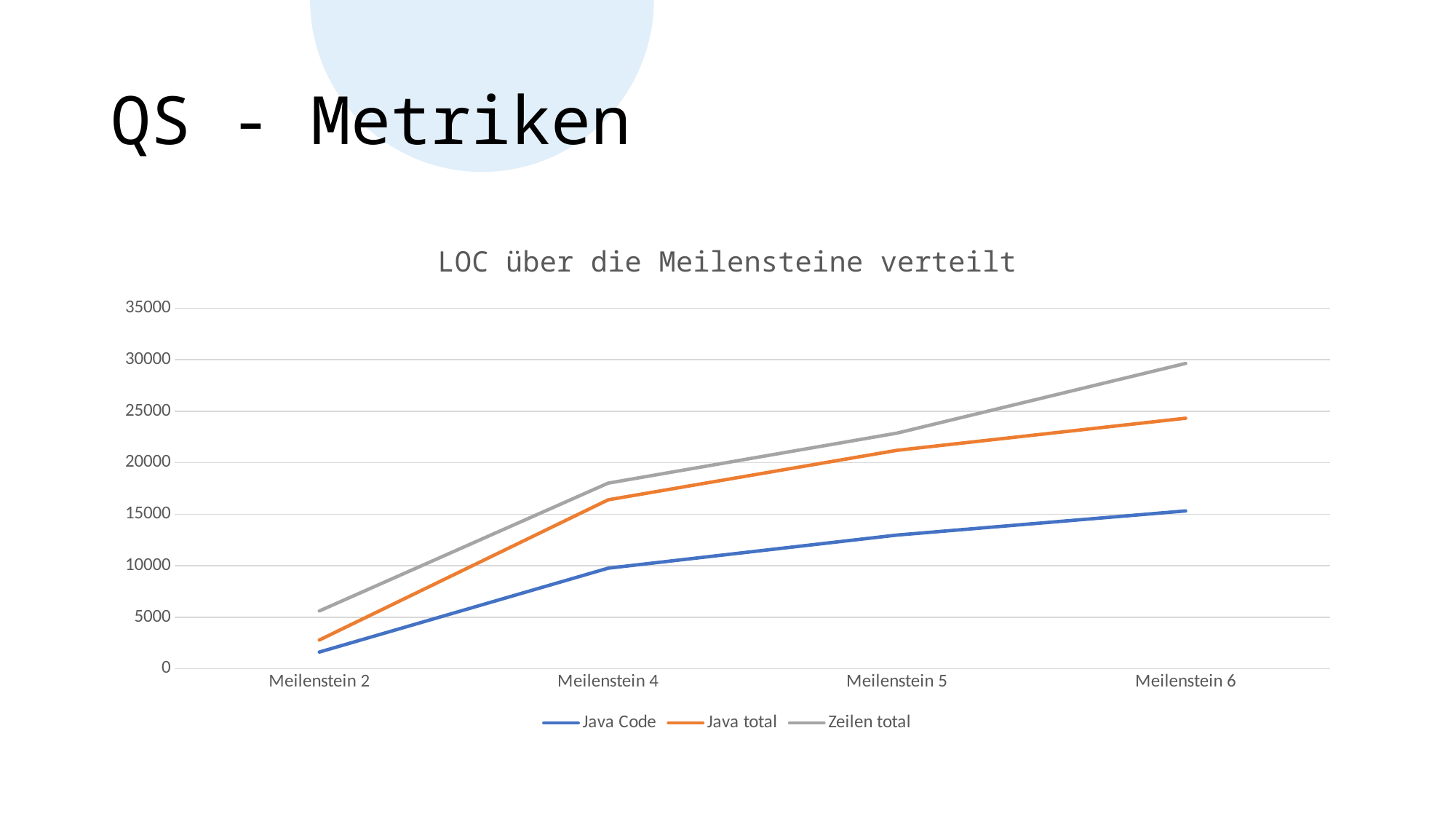
Which series has the highest value at Meilenstein 6? Zeilen total What kind of chart is shown on the slide? line chart Which series has the lowest value at Meilenstein 2? Java Code Is the value for Java total at Meilenstein 5 greater or less than 20000? greater Do the values for Java Code rise or fall from Meilenstein 2 to Meilenstein 6? rise Which is larger at Meilenstein 5: Java Code or Java total? Java total Is the value for Zeilen total at Meilenstein 6 greater or less than 25000? greater How many milestones are shown on the x axis? 4 How many series does the legend list? 3 Is the value for Java Code at Meilenstein 2 greater or less than 5000? less What is the title of the chart? LOC über die Meilensteine verteilt